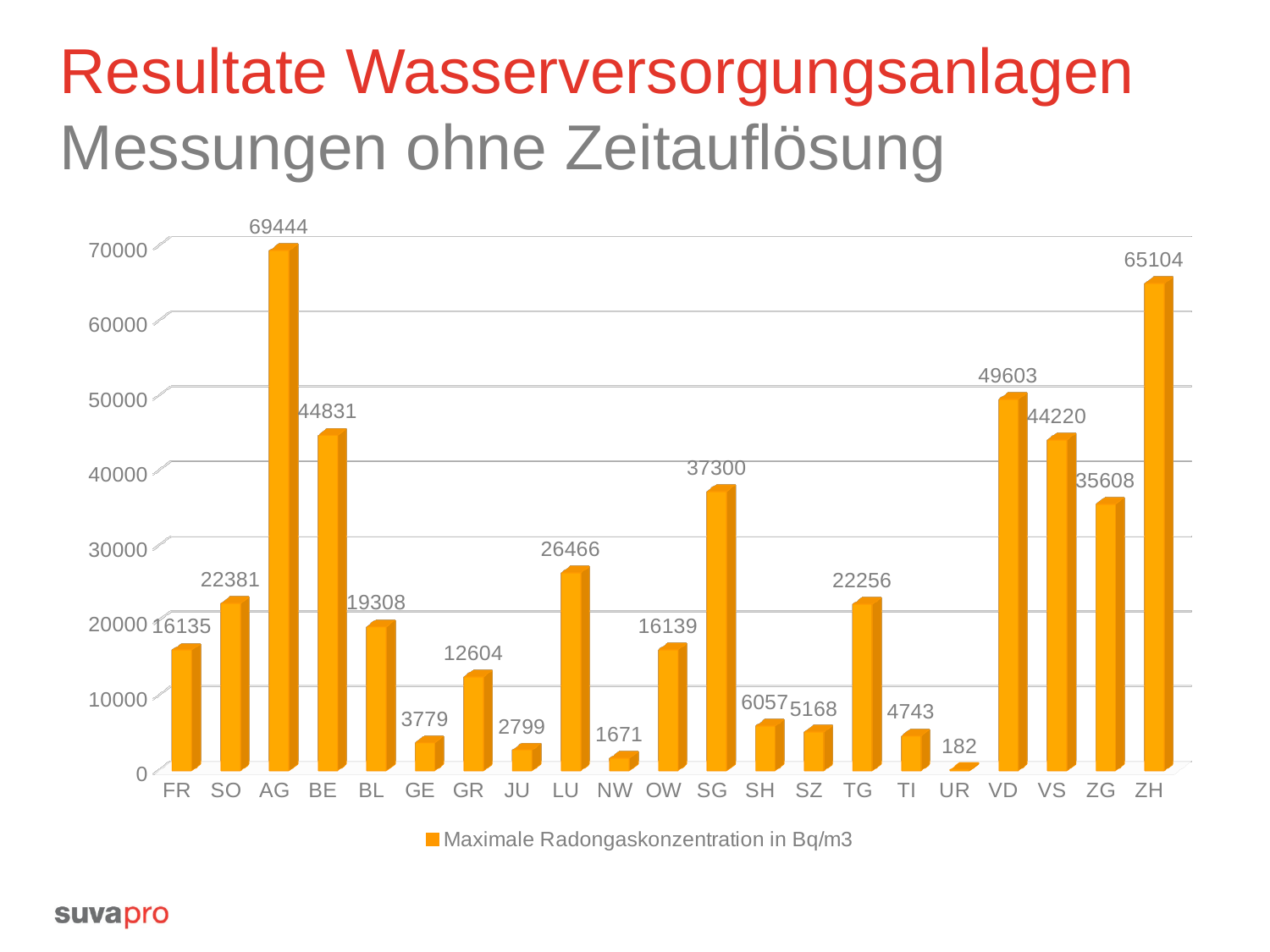
What is the maximum radon gas concentration shown for AG? 69444 How many series does the legend list? 1 Which canton has the lowest value in the chart? UR What is the difference between the values for VD and VS? 5383 What is the difference between the values for AG and ZH? 4340 What value is shown for the canton UR? 182 Which has the larger value, BE or LU? BE Which canton has the highest maximum radon gas concentration? AG How many cantons are shown on the x axis? 21 Is the value for ZG greater or less than 30000? greater What is the value plotted for SG? 37300 What kind of chart is shown on the slide? bar chart